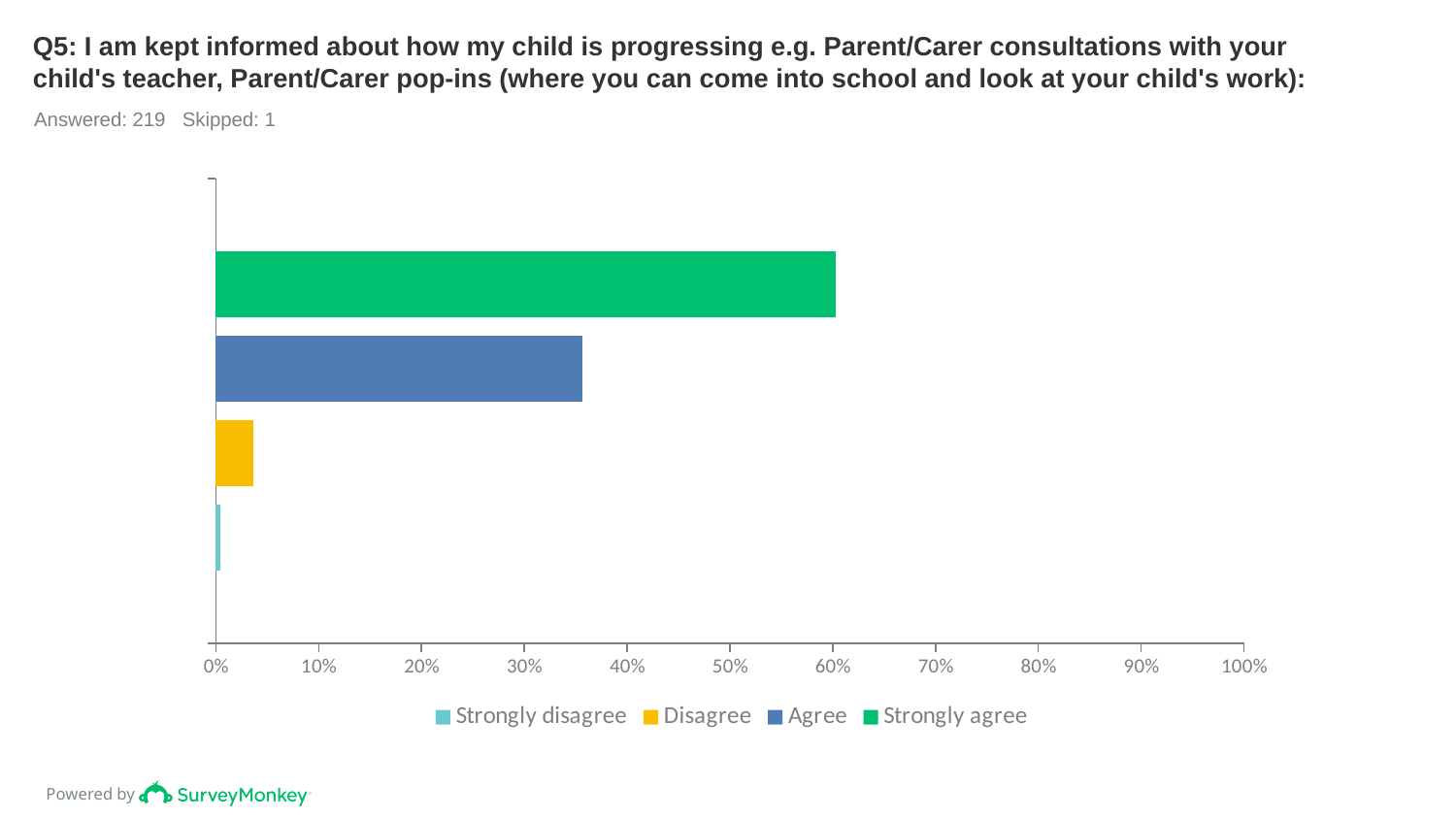
Is the value for Strongly agree greater or less than 50%? greater How many entries does the chart legend list? 4 What colour is the bar for Strongly agree? green What kind of chart is shown on the slide? bar chart Is the value for Agree greater or less than 30%? greater Which is larger, the value for Agree or the value for Disagree? Agree How many respondents answered this question according to the slide? 219 Which response option has the lowest value in the chart? Strongly disagree Which is larger, the value for Strongly agree or the value for Agree? Strongly agree Which response option has the highest value in the chart? Strongly agree Is the value for Agree greater or less than 40%? less